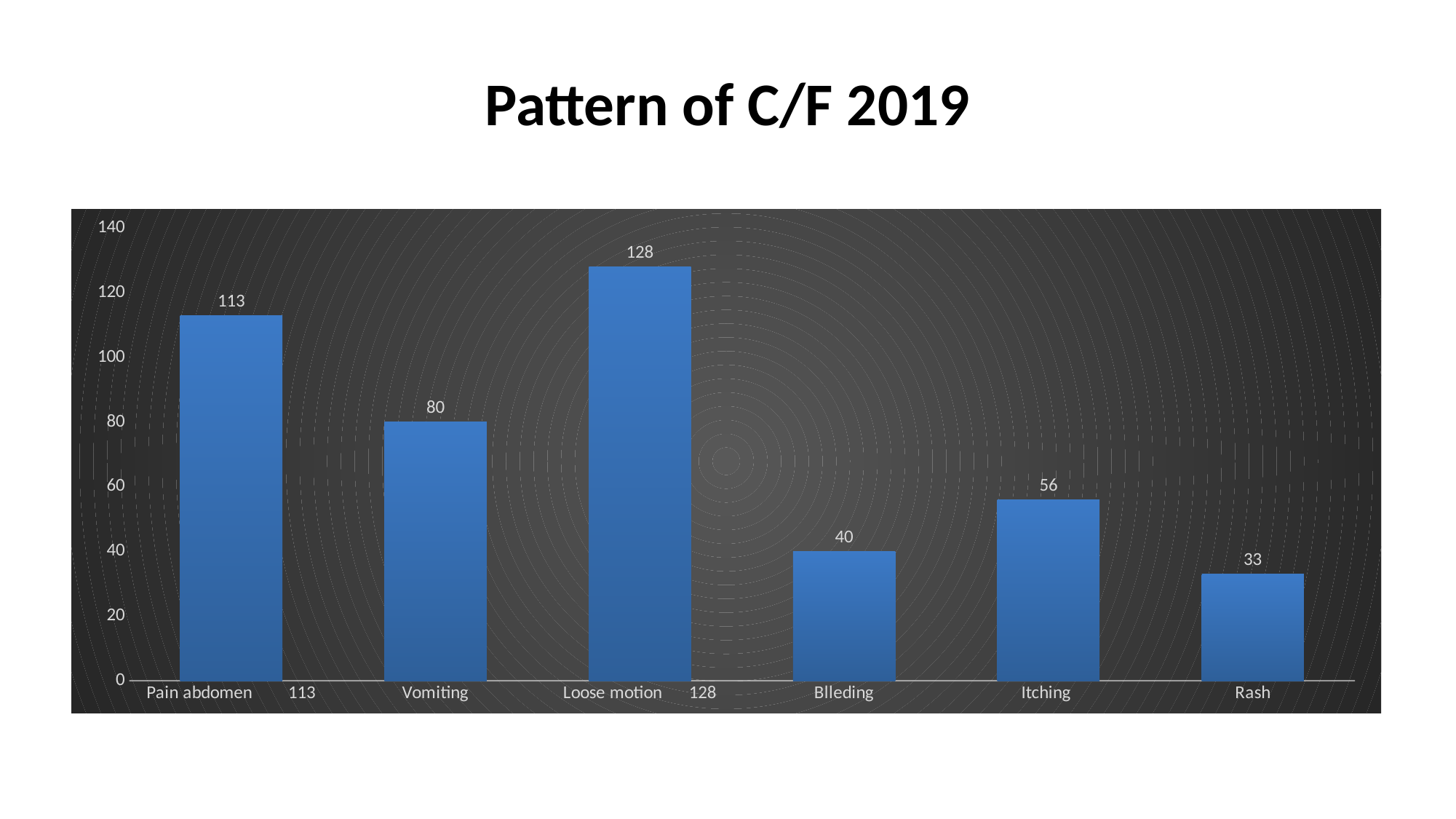
What is the difference between the values for Itching and Blleding? 16 What is the difference between the values for Loose motion and Pain abdomen? 15 How many categories are shown on the x axis? 6 What is the value for Rash? 33 Is the value for Pain abdomen greater or less than 100? greater Which category has the highest value? Loose motion Which category has the lowest value? Rash Which is larger, the value for Vomiting or the value for Itching? Vomiting What is the value for Itching? 56 What is the value for Vomiting? 80 What is the value for Loose motion? 128 What kind of chart is shown on the slide? bar chart